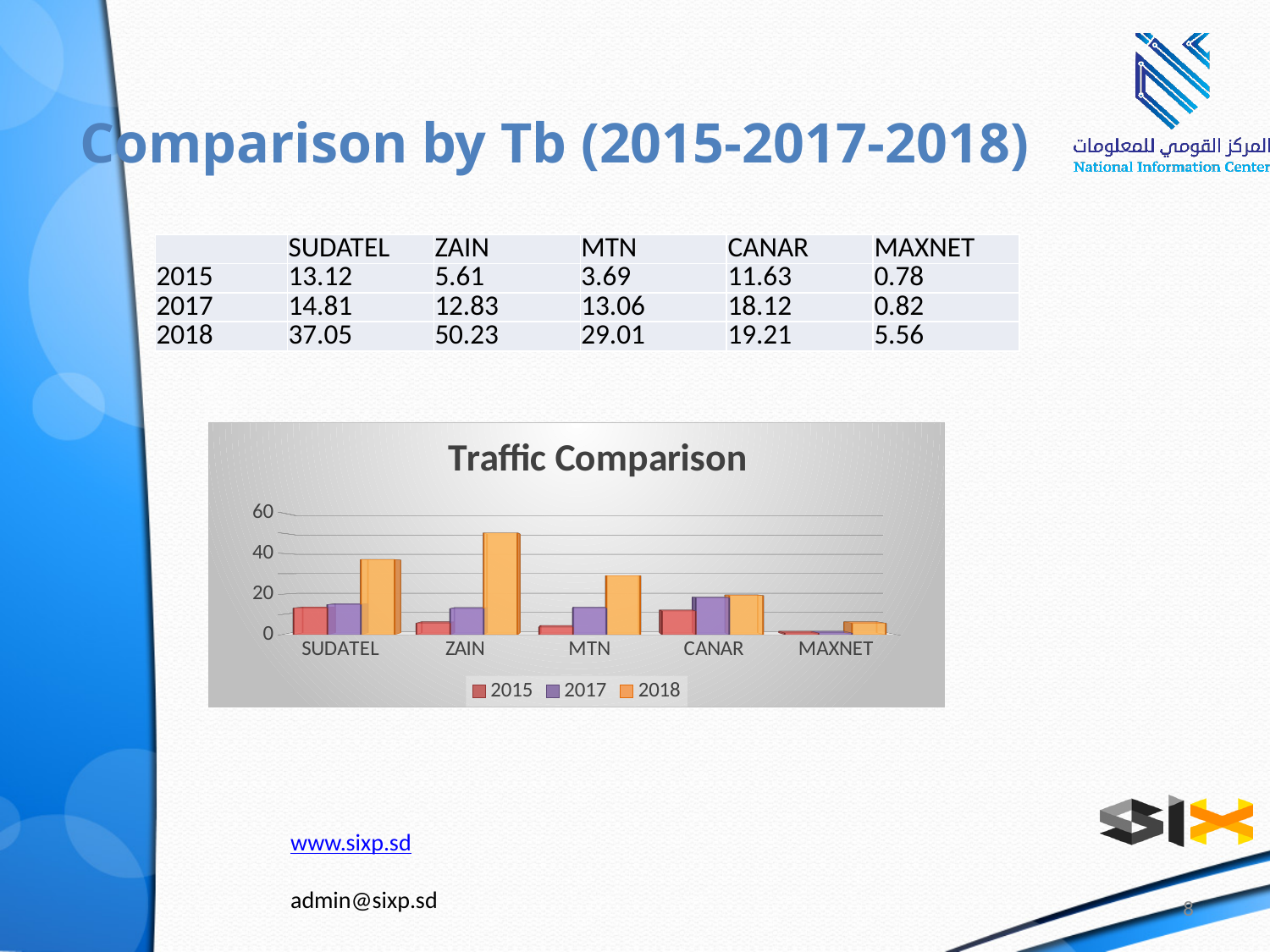
Is the 2017 value for MTN in the Traffic Comparison chart greater or less than 20? less How many series does the legend of the Traffic Comparison chart list? 3 What type of chart is the Traffic Comparison chart? bar chart According to the table, what is the 2015 value for MAXNET? 0.78 Which category has the lowest 2018 value in the Traffic Comparison chart? MAXNET Which category has the highest 2018 value in the Traffic Comparison chart? ZAIN Which series is shown in orange in the Traffic Comparison chart? 2018 In the Traffic Comparison chart, which is larger for CANAR: the 2015 value or the 2018 value? 2018 Is the 2018 value for ZAIN in the Traffic Comparison chart greater or less than 40? greater According to the table, what is the 2018 value for SUDATEL? 37.05 What is the title of the chart on the slide? Traffic Comparison How many categories are shown on the x axis of the Traffic Comparison chart? 5